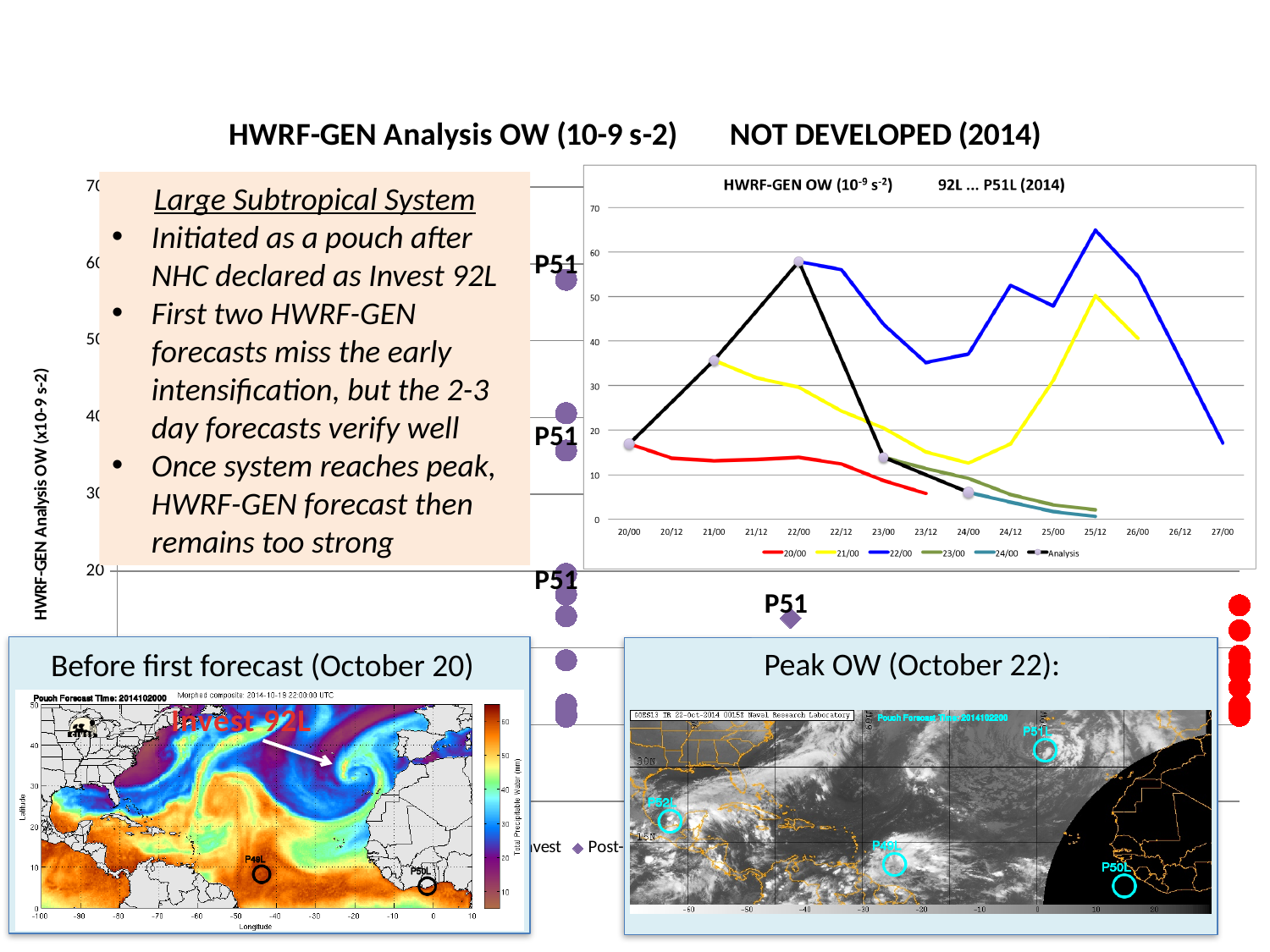
In the chart titled "HWRF-GEN OW (10-9 s-2) 92L ... P51L (2014)", is the value of the 20/00 series at 23/12 greater or less than 10? less In the chart titled "HWRF-GEN OW (10-9 s-2) 92L ... P51L (2014)", at 23/00, which is larger: the 22/00 series or the 21/00 series? 22/00 In the chart titled "HWRF-GEN OW (10-9 s-2) 92L ... P51L (2014)", is the Analysis value at 22/00 greater or less than 50? greater In the chart titled "HWRF-GEN OW (10-9 s-2) 92L ... P51L (2014)", how many series does the legend list? 6 In the chart titled "HWRF-GEN OW (10-9 s-2) 92L ... P51L (2014)", is the peak value of the 22/00 series greater or less than 60? greater In the chart titled "HWRF-GEN OW (10-9 s-2) 92L ... P51L (2014)", what kind of chart is shown? line chart In the chart titled "HWRF-GEN OW (10-9 s-2) 92L ... P51L (2014)", does the 20/00 series generally rise or fall along the x axis? fall In the chart titled "HWRF-GEN OW (10-9 s-2) 92L ... P51L (2014)", what colour is the 22/00 series line? blue In the chart titled "HWRF-GEN OW (10-9 s-2) 92L ... P51L (2014)", how many tick labels are shown on the x axis? 15 In the chart titled "HWRF-GEN OW (10-9 s-2) 92L ... P51L (2014)", how many points are plotted for the Analysis series? 5 In the chart titled "HWRF-GEN OW (10-9 s-2) 92L ... P51L (2014)", which series reaches the highest value on the chart? 22/00 In the chart titled "HWRF-GEN OW (10-9 s-2) 92L ... P51L (2014)", at 22/00, which is larger: the Analysis value or the 20/00 series value? Analysis